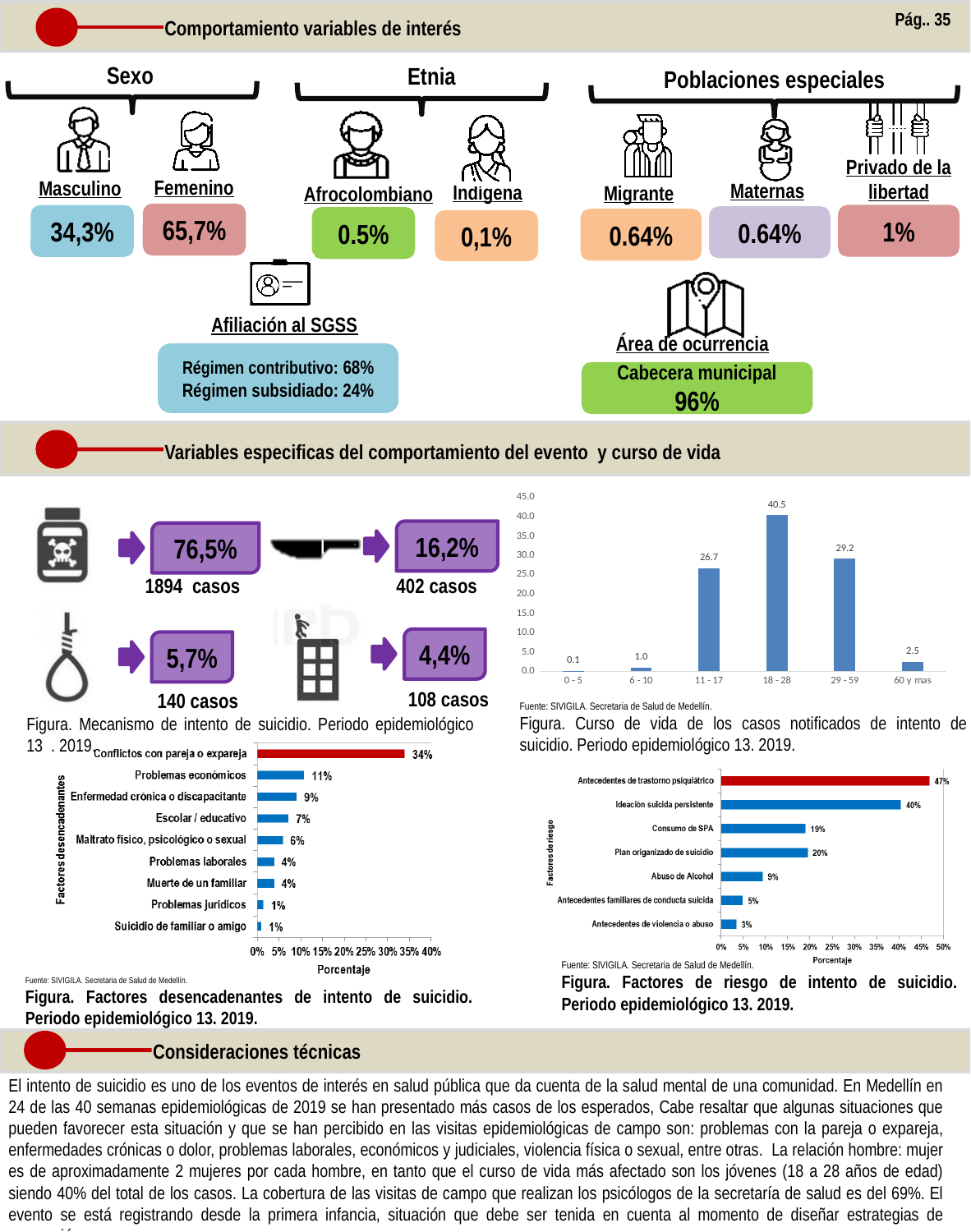
In the 'Curso de vida' bar chart (top right), what is the difference between the 18 - 28 and 29 - 59 values? 11.3 In the 'Factores desencadenantes' chart (bottom left), which factor has the highest value? Conflictos con pareja o expareja In the 'Factores de riesgo' chart (bottom right), what is the value for Consumo de SPA? 19% In the 'Factores de riesgo' chart (bottom right), what is the difference between Antecedentes de trastorno psiquiátrico and Abuso de Alcohol? 38% In the 'Factores desencadenantes' chart (bottom left), what type of chart is used? Bar chart In the 'Factores de riesgo' chart (bottom right), which is larger: Ideación suicida persistente or Plan organizado de suicidio? Ideación suicida persistente In the 'Factores desencadenantes' chart (bottom left), how many factors are listed? 9 In the 'Curso de vida' bar chart (top right), what is the value for the 18 - 28 age group? 40.5 In the 'Curso de vida' bar chart (top right), which age group has the lowest value? 0 - 5 In the 'Curso de vida' bar chart (top right), is the value for 11 - 17 greater or less than 25.0? greater In the 'Factores desencadenantes' chart (bottom left), what is the value for Problemas económicos? 11% In the 'Curso de vida' bar chart (top right), how many age groups are shown? 6